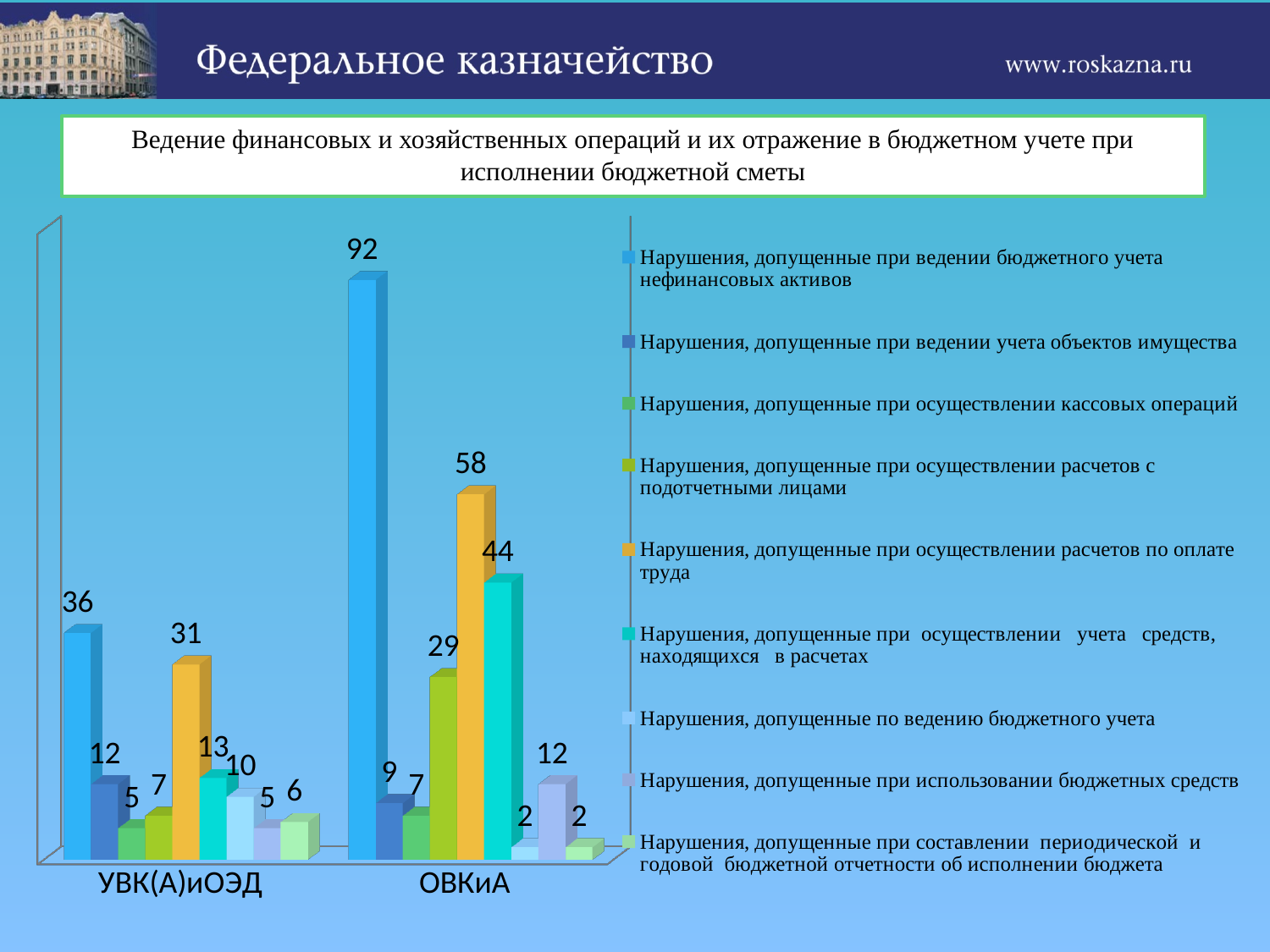
What colour are the bars for the series "Нарушения, допущенные при осуществлении расчетов по оплате труда"? orange-yellow What is the value for ОВКиА in the series "Нарушения, допущенные при использовании бюджетных средств"? 12 What is the value for УВК(А)иОЭД in the series "Нарушения, допущенные при осуществлении расчетов по оплате труда"? 31 Which category has the highest value in the series "Нарушения, допущенные при осуществлении расчетов по оплате труда"? ОВКиА What is the value for ОВКиА in the series "Нарушения, допущенные при осуществлении учета средств, находящихся в расчетах"? 44 How many series does the chart legend list? 9 How many categories are shown on the x axis of the chart? 2 What is the difference between the ОВКиА and УВК(А)иОЭД values in the series "Нарушения, допущенные при ведении бюджетного учета нефинансовых активов"? 56 What type of chart is shown on the slide? bar chart What is the value for ОВКиА in the series "Нарушения, допущенные при ведении бюджетного учета нефинансовых активов"? 92 What is the value for УВК(А)иОЭД in the series "Нарушения, допущенные при ведении учета объектов имущества"? 12 Which is larger: the value for УВК(А)иОЭД or for ОВКиА in the series "Нарушения, допущенные при осуществлении расчетов с подотчетными лицами"? ОВКиА